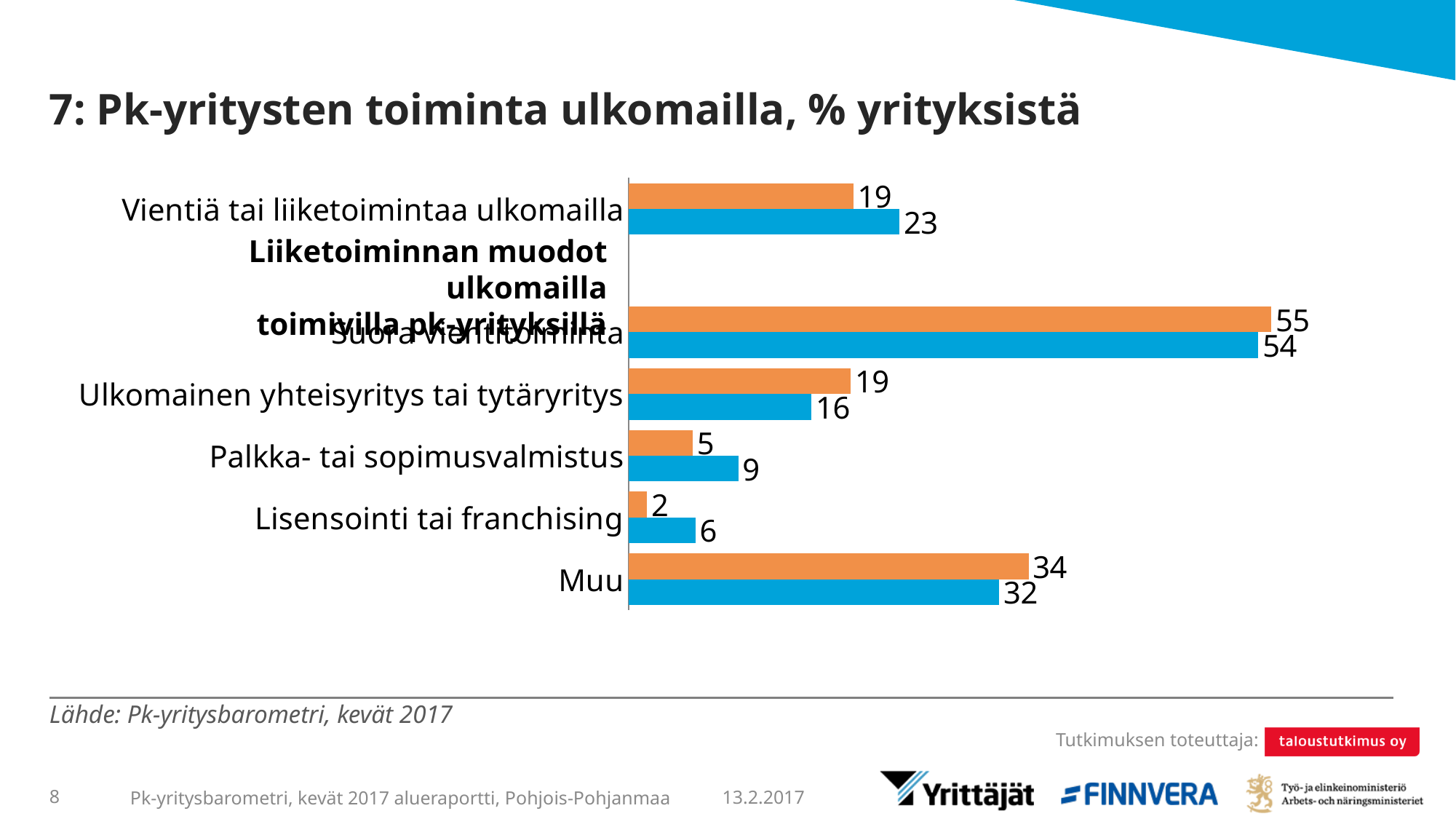
How many categories are plotted in the chart? 6 What is the value of the blue bar for "Vientiä tai liiketoimintaa ulkomailla"? 23 What is the value of the orange bar for "Muu"? 34 What is the value of the blue bar for "Lisensointi tai franchising"? 6 For "Palkka- tai sopimusvalmistus", how much larger is the blue bar than the orange bar? 4 What is the value of the orange bar for "Vientiä tai liiketoimintaa ulkomailla"? 19 For "Ulkomainen yhteisyritys tai tytäryritys", which bar is larger, the orange or the blue? orange What kind of chart is shown on the slide? bar chart Which category has the lowest orange bar value? Lisensointi tai franchising For "Muu", what is the difference between the orange bar and the blue bar? 2 What is the value of the blue bar for "Ulkomainen yhteisyritys tai tytäryritys"? 16 What is the value of the orange bar for "Palkka- tai sopimusvalmistus"? 5